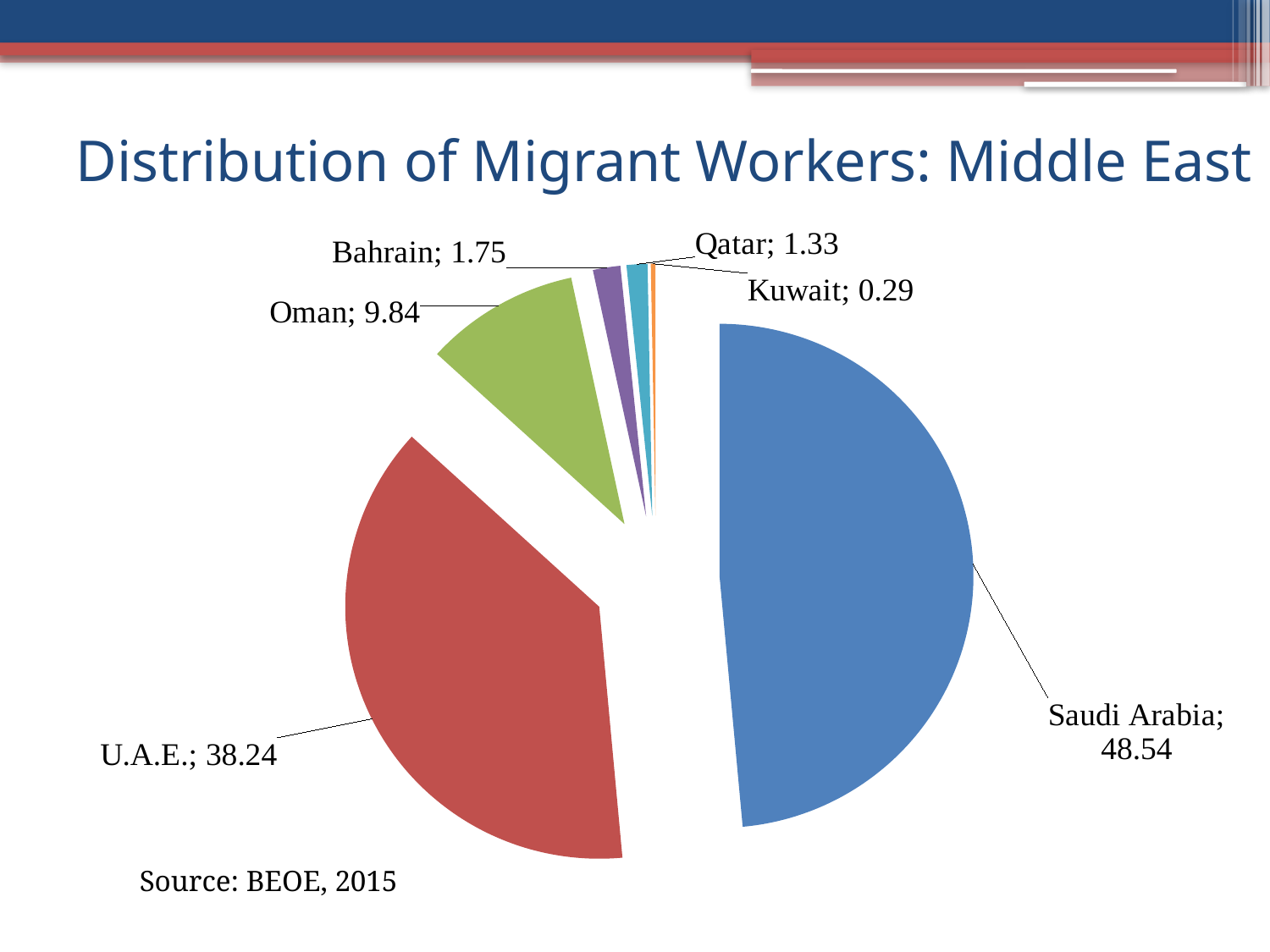
Which country has the largest slice of the pie? Saudi Arabia What is the difference between the values for Saudi Arabia and U.A.E.? 10.30 How many countries are shown in the pie chart? 6 What kind of chart is shown on the slide? Pie chart What is the difference between the values for Bahrain and Qatar? 0.42 What value is shown for Saudi Arabia? 48.54 What value is shown for U.A.E.? 38.24 What value is shown for Kuwait? 0.29 What is the title of the slide? Distribution of Migrant Workers: Middle East What value is shown for Oman? 9.84 Which country has the smallest slice of the pie? Kuwait Which is larger, the value for Oman or the value for Bahrain? Oman